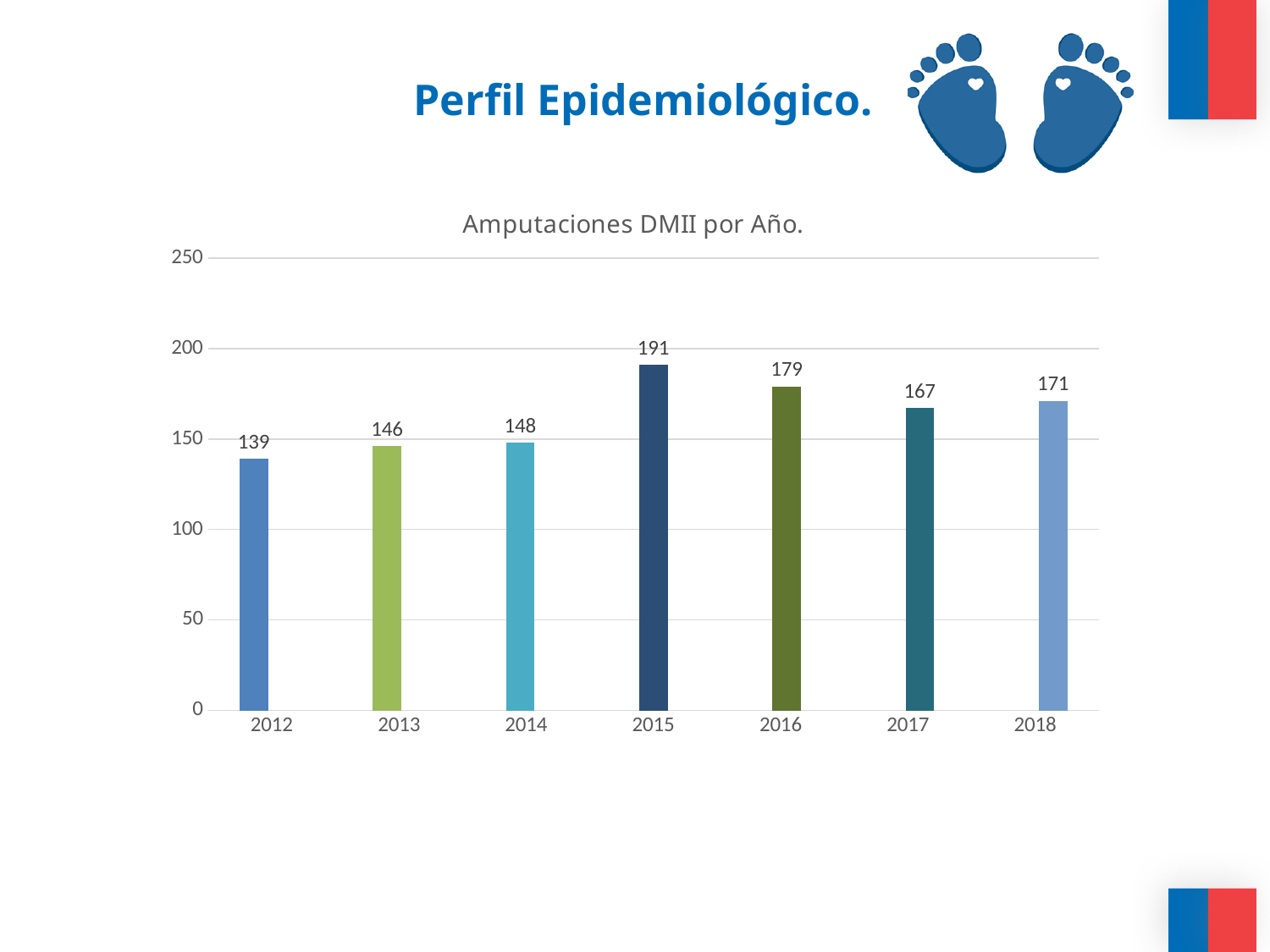
How many years are shown on the x axis? 7 What is the value for 2017? 167 What is the difference between the values for 2015 and 2012? 52 Which year has the highest value? 2015 What kind of chart is this? bar chart Is the value for 2016 greater or less than 150? greater What is the value for 2012? 139 What is the title of the chart? Amputaciones DMII por Año. Which is larger, the value for 2018 or the value for 2017? 2018 Which year has the lowest value? 2012 What is the value for 2015? 191 What is the difference between the values for 2016 and 2017? 12